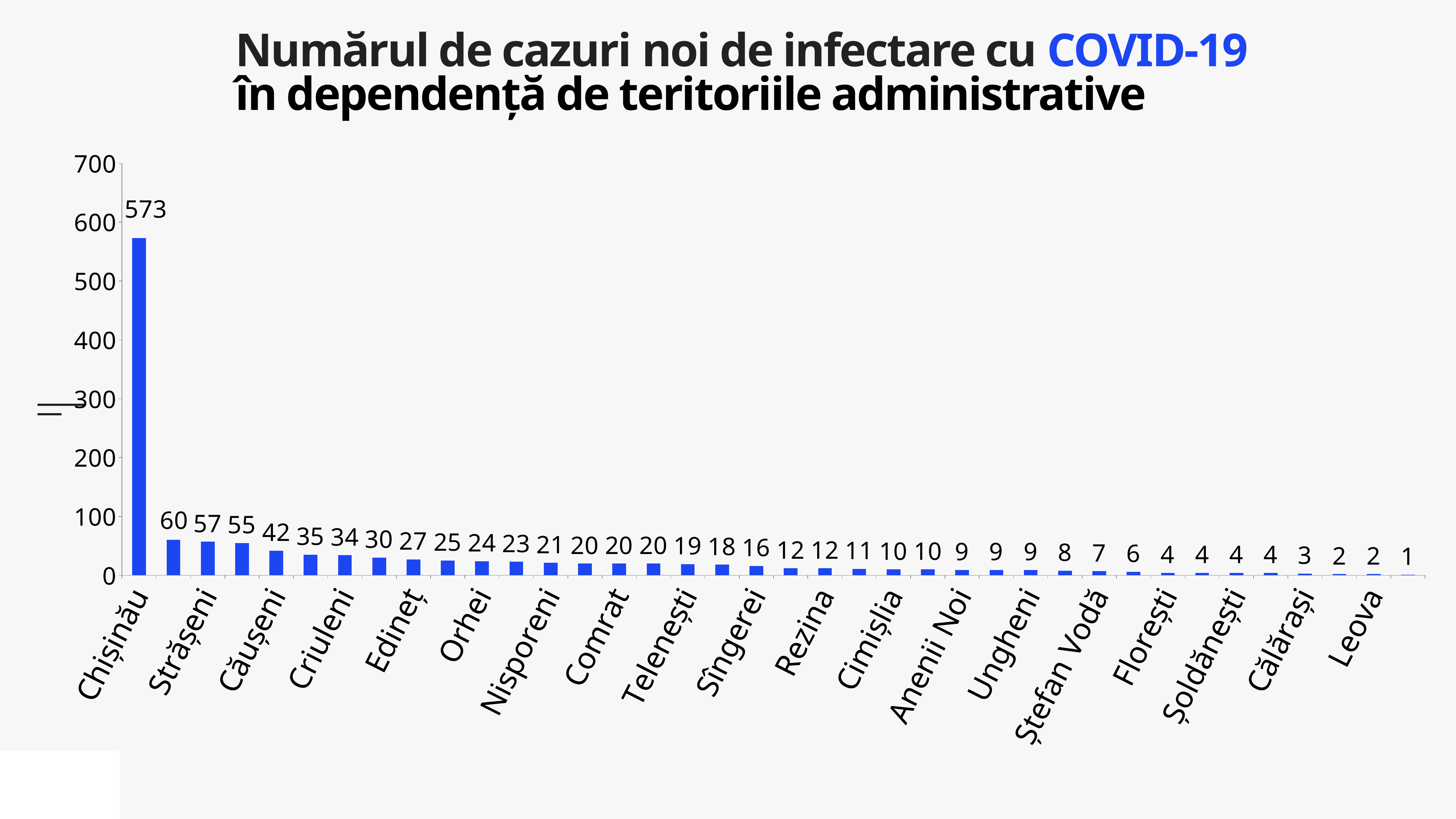
What is the value for Chișinău? 573 Do the values rise or fall moving from left to right along the x axis? Fall Is the value for Chișinău greater or less than 500? greater What kind of chart is shown on the slide? Bar chart Is the value for Strășeni greater or less than 100? less Which category has the highest value? Chișinău What is the difference between the largest data label (573) and the smallest data label (1)? 572 What is the smallest data label printed on the chart? 1 What is the highest value shown on the vertical axis? 700 What is the title of the chart? Numărul de cazuri noi de infectare cu COVID-19 în dependență de teritoriile administrative Is the value for Leova greater or less than 100? less Which is larger, the value for Chișinău or the value for Orhei? Chișinău